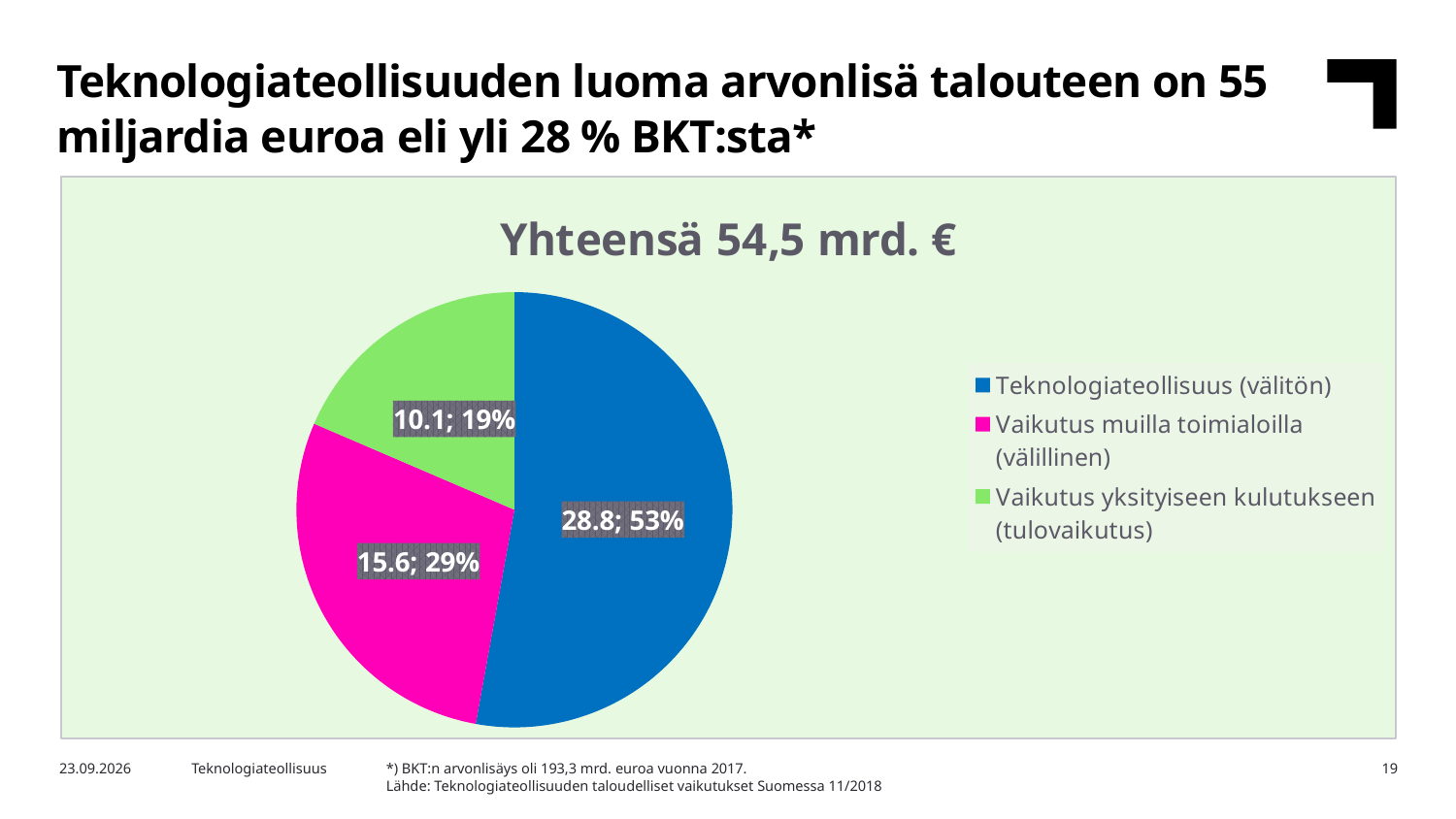
What value is shown for Teknologiateollisuus (välitön)? 28.8 What kind of chart is shown on the slide? pie chart How many slices does the pie chart have? 3 What is the difference between the values for Teknologiateollisuus (välitön) and Vaikutus muilla toimialoilla (välillinen)? 13.2 What share of the pie does Vaikutus yksityiseen kulutukseen (tulovaikutus) represent? 19% Which slice is the smallest? Vaikutus yksityiseen kulutukseen (tulovaikutus) What is the title of the chart? Yhteensä 54,5 mrd. € What value is shown for Vaikutus yksityiseen kulutukseen (tulovaikutus)? 10.1 How many entries does the legend list? 3 What share of the pie does Teknologiateollisuus (välitön) represent? 53% Which slice is the largest? Teknologiateollisuus (välitön) What value is shown for Vaikutus muilla toimialoilla (välillinen)? 15.6